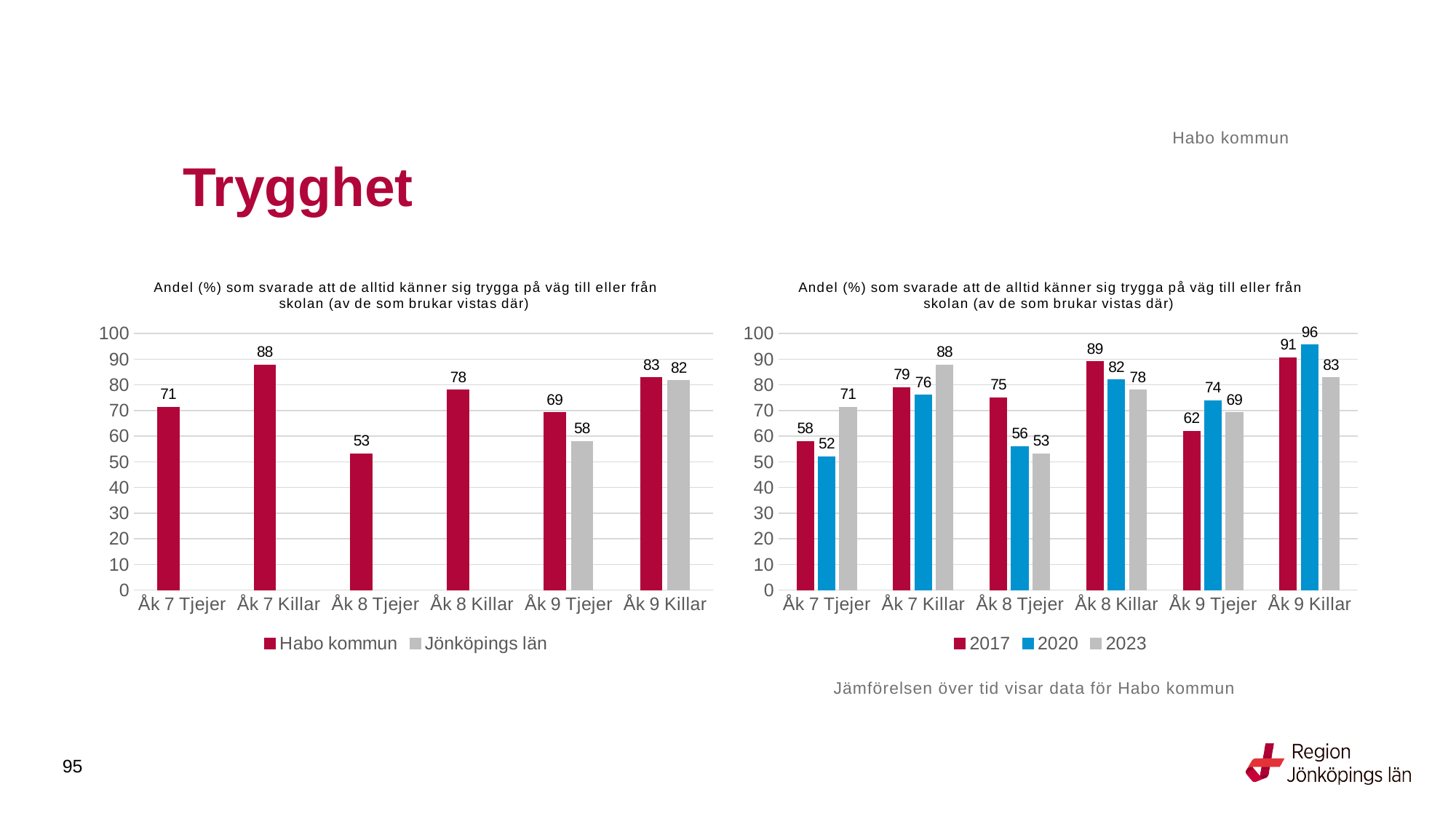
In the right chart, how many categories are shown on the x axis? 6 What kind of chart is the right chart? Bar chart In the right chart, which is larger for Åk 9 Tjejer: the 2017 value or the 2020 value? 2020 In the left chart, what is the difference between Habo kommun and Jönköpings län for Åk 9 Tjejer? 11 In the left chart, which category has the lowest value for Habo kommun? Åk 8 Tjejer In the left chart, how many series does the legend list? 2 In the right chart, what is the value for 2017 for Åk 8 Tjejer? 75 In the left chart, what is the value for Jönköpings län for Åk 9 Tjejer? 58 In the left chart, what is the value for Habo kommun for Åk 7 Killar? 88 In the right chart, what is the difference between the 2017 and 2020 values for Åk 8 Tjejer? 19 In the right chart, which category has the highest value for 2023? Åk 7 Killar In the right chart, what is the value for 2020 for Åk 9 Killar? 96